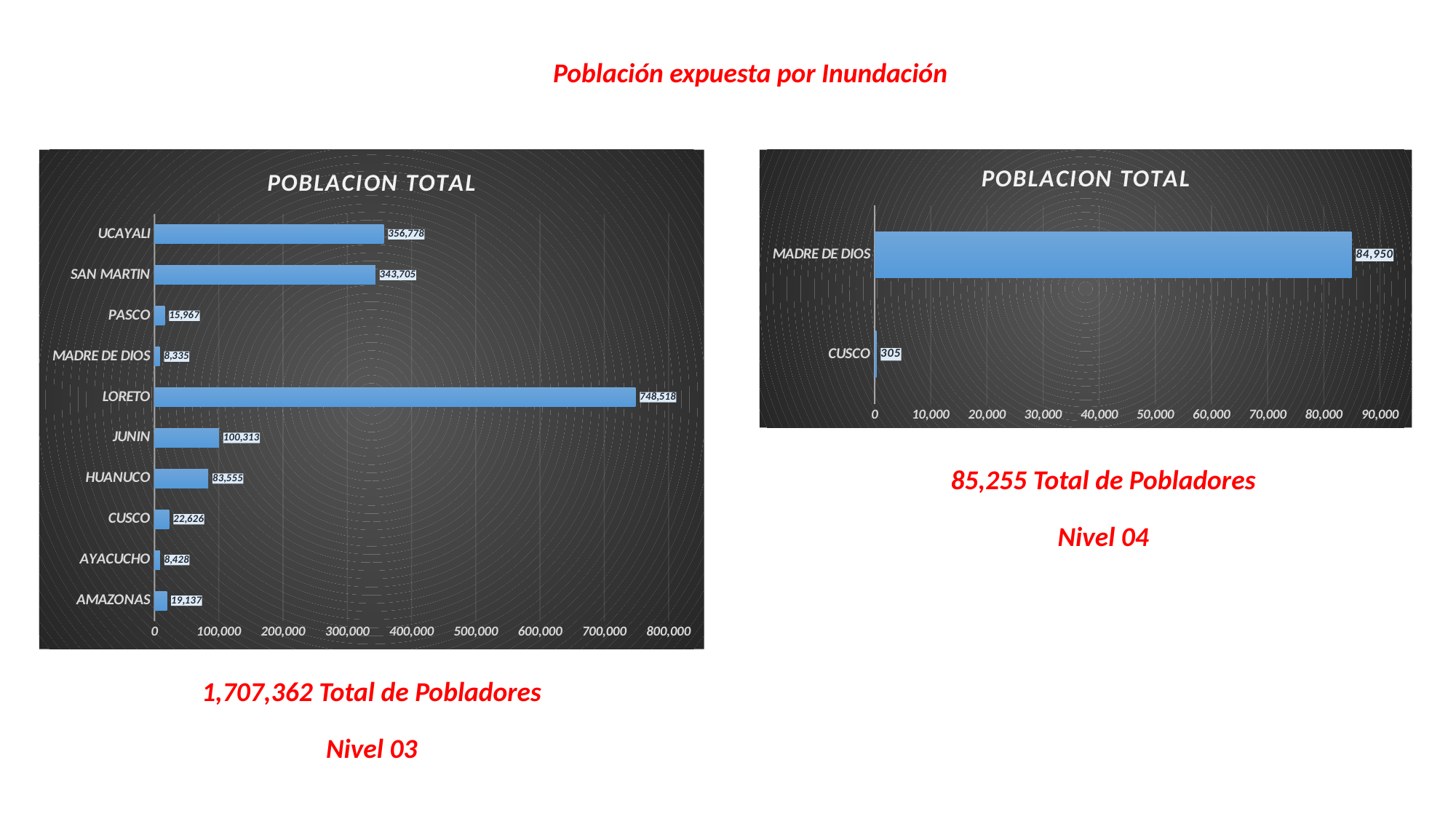
In the right chart (Nivel 04), what is the value for MADRE DE DIOS? 84,950 In the left chart (Nivel 03), which category has the highest value? LORETO In the left chart (Nivel 03), which is larger, the value for HUANUCO or the value for CUSCO? HUANUCO In the left chart (Nivel 03), what is the difference between the values for LORETO and UCAYALI? 391,740 How many categories are shown in the left chart (Nivel 03)? 10 What kind of chart is the right chart (Nivel 04)? bar chart In the right chart (Nivel 04), what is the value for CUSCO? 305 In the left chart (Nivel 03), what is the value for JUNIN? 100,313 In the right chart (Nivel 04), which category has the lowest value? CUSCO In the left chart (Nivel 03), is the value for SAN MARTIN greater or less than 300,000? greater In the left chart (Nivel 03), what is the value for LORETO? 748,518 In the right chart (Nivel 04), what is the difference between the values for MADRE DE DIOS and CUSCO? 84,645